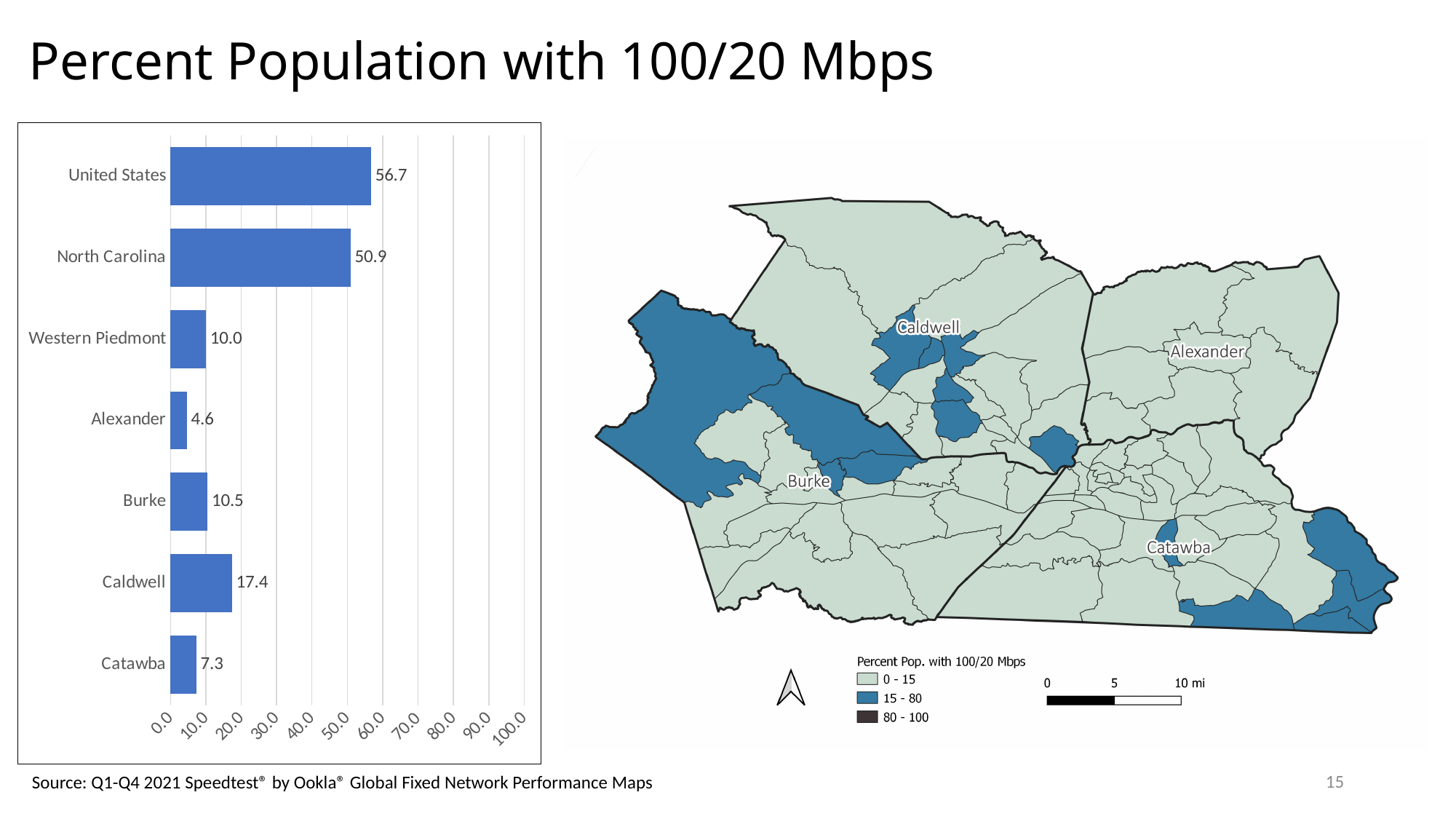
What kind of chart is shown on the left of the slide? bar chart What is the value for Caldwell in the bar chart? 17.4 Which category has the lowest value in the bar chart? Alexander Is the value for Caldwell in the bar chart greater or less than 20.0? less Which category has the highest value in the bar chart? United States How many categories are shown in the bar chart? 7 What is the value for Catawba in the bar chart? 7.3 What is the difference between the United States and North Carolina values in the bar chart? 5.8 What is the value for North Carolina in the bar chart? 50.9 Which has a larger value in the bar chart, Burke or Western Piedmont? Burke What is the title of the slide? Percent Population with 100/20 Mbps What is the difference between the Caldwell and Burke values in the bar chart? 6.9